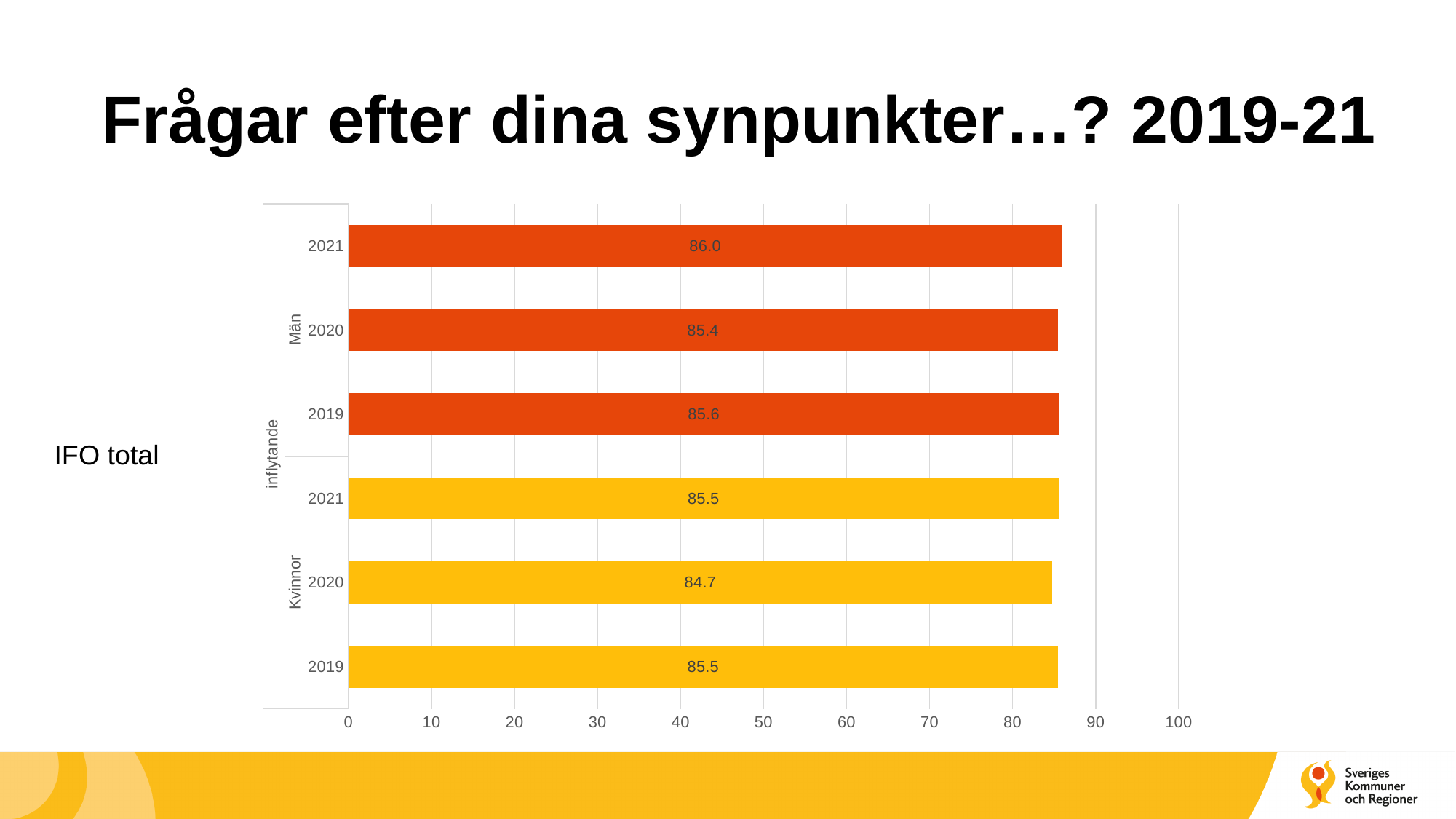
What is the value for Män in 2019? 85.6 Is the value for Kvinnor in 2019 greater or less than 80? greater What label is written along the vertical axis of the chart? inflytande Which bar has the highest value? Män 2021 Which is larger, the Män 2020 value or the Kvinnor 2020 value? Män 2020 What is the value for Kvinnor in 2020? 84.7 What kind of chart is shown on the slide? bar chart How many bars are shown in the chart? 6 What is the value for Kvinnor in 2021? 85.5 What is the difference between the Män 2021 value and the Kvinnor 2020 value? 1.3 Which bar has the lowest value? Kvinnor 2020 What is the value for Män in 2021? 86.0